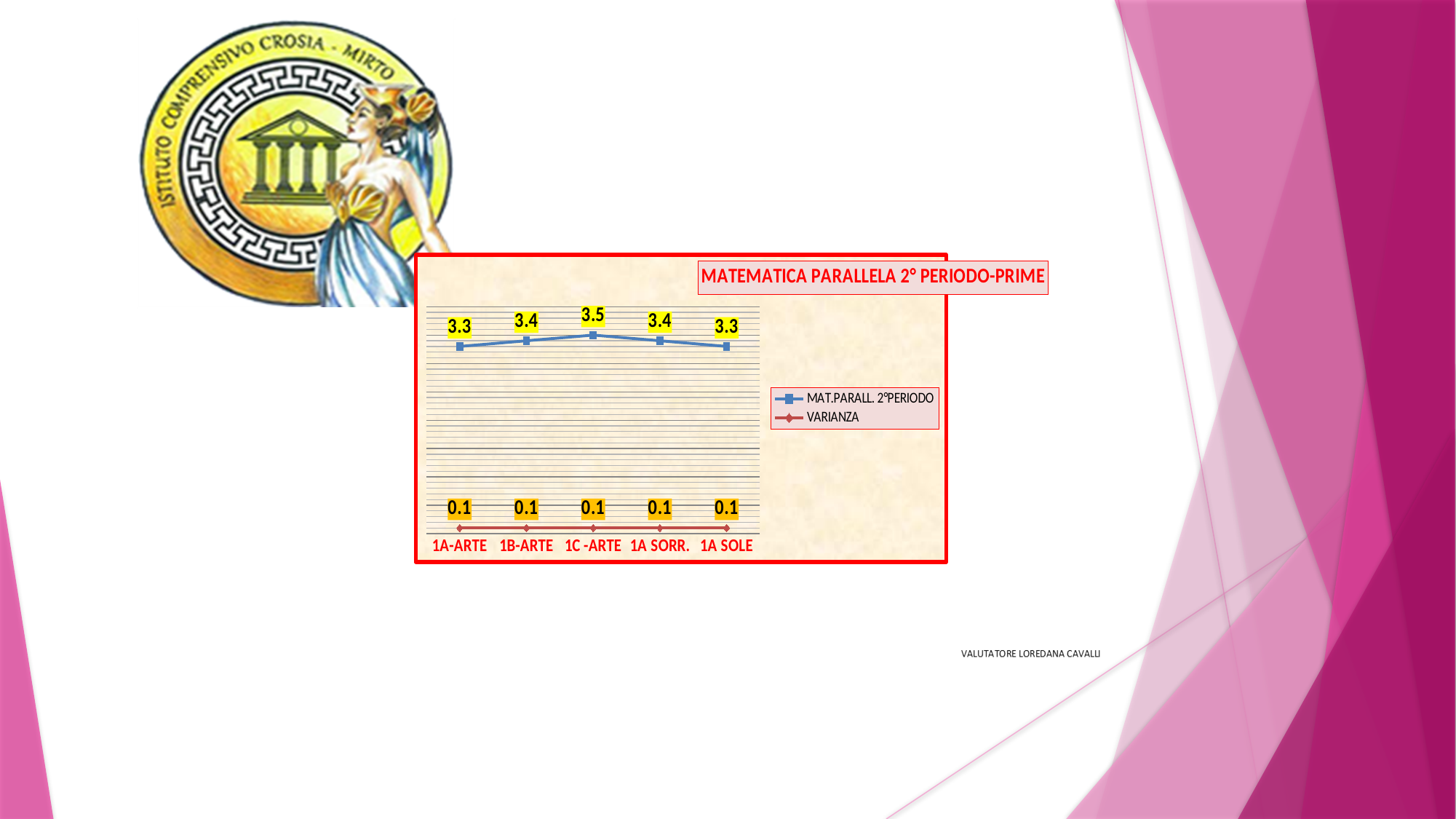
What is the MAT.PARALL. 2°PERIODO value for 1A SOLE? 3.3 What is the title of the chart? MATEMATICA PARALLELA 2° PERIODO-PRIME What colour is the VARIANZA line in the chart? Red What is the MAT.PARALL. 2°PERIODO value for 1C -ARTE? 3.5 What kind of chart is shown on the slide? Line chart Which has a larger MAT.PARALL. 2°PERIODO value, 1B-ARTE or 1A SOLE? 1B-ARTE Does the MAT.PARALL. 2°PERIODO series rise or fall from 1C -ARTE to 1A SOLE? Fall Which category has the highest MAT.PARALL. 2°PERIODO value? 1C -ARTE How many categories are shown on the x axis? 5 How many series does the legend list? 2 What is the VARIANZA value for 1B-ARTE? 0.1 What is the difference between the MAT.PARALL. 2°PERIODO values for 1C -ARTE and 1A-ARTE? 0.2